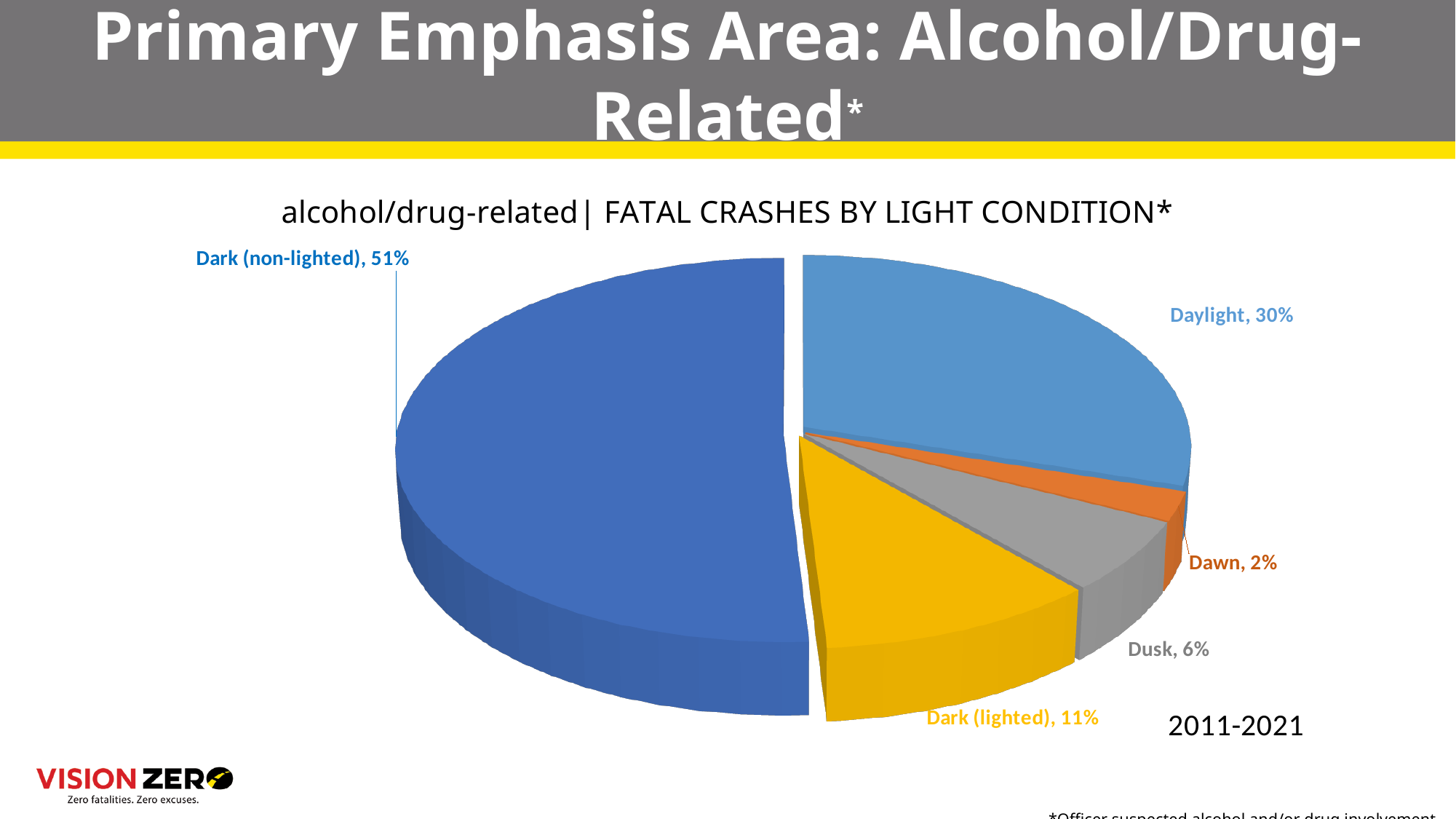
What type of chart is shown on the slide? Pie chart What share of alcohol/drug-related fatal crashes occurred in Dark (lighted) conditions? 11% What share of alcohol/drug-related fatal crashes occurred at Dawn? 2% Which light condition has the smallest share of alcohol/drug-related fatal crashes? Dawn What year range does the chart cover? 2011-2021 What is the title of the chart? alcohol/drug-related | FATAL CRASHES BY LIGHT CONDITION* What is the difference in percentage points between the Dark (non-lighted) and Daylight shares? 21 Which has a larger share of fatal crashes, Dusk or Dark (lighted)? Dark (lighted) How many light condition categories are shown in the pie chart? 5 What share of alcohol/drug-related fatal crashes occurred in Dark (non-lighted) conditions? 51% Which light condition has the largest share of alcohol/drug-related fatal crashes? Dark (non-lighted) What share of alcohol/drug-related fatal crashes occurred in Daylight? 30%